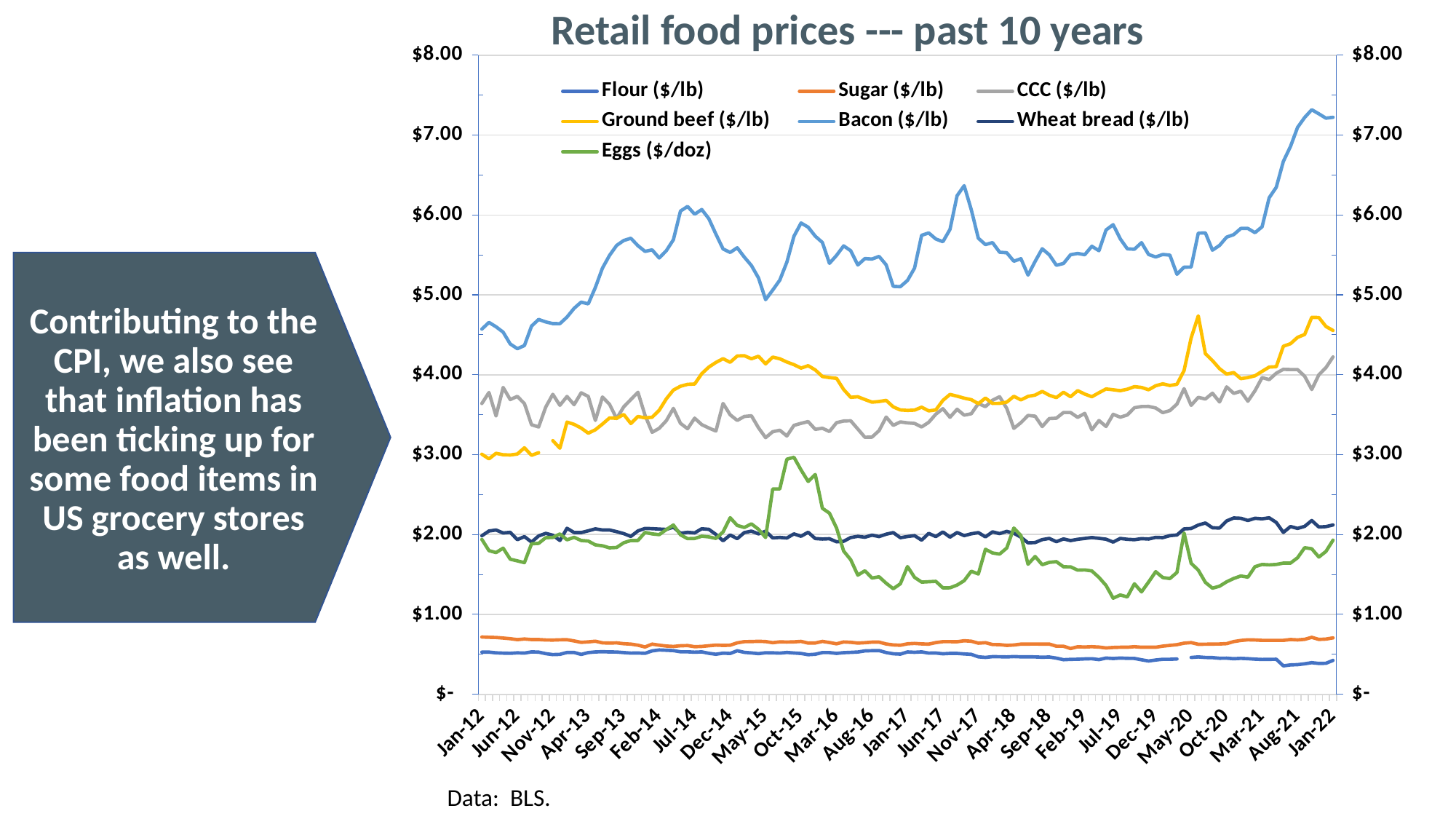
What is the data source cited below the chart? BLS What is the title of the chart? Retail food prices --- past 10 years Is the value for Sugar ($/lb) at Jan-12 greater or less than $1.00? less Which series has the lowest prices across the whole period? Flour ($/lb) Which series has the highest prices across the whole period? Bacon ($/lb) Is the highest value reached by Eggs ($/doz) greater or less than $2.00? greater Which is larger at Jan-17: Wheat bread ($/lb) or Eggs ($/doz)? Wheat bread ($/lb) Is the value for Ground beef ($/lb) at Jan-22 greater or less than $4.00? greater What kind of chart is shown on the slide? line chart Does the Bacon ($/lb) line rise or fall from Mar-21 to Jan-22? rise How many series does the legend list? 7